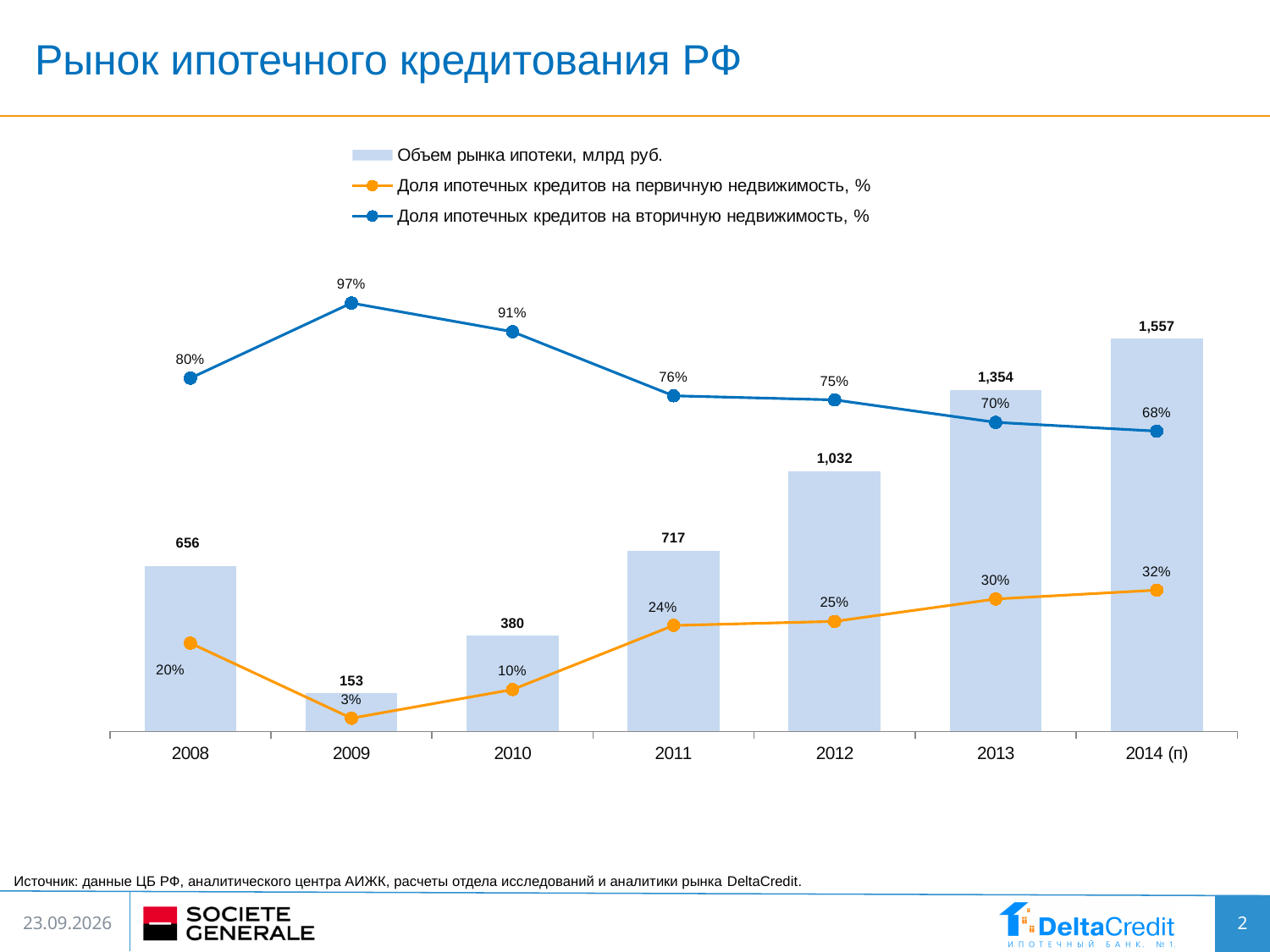
In which year is "Объем рынка ипотеки, млрд руб." the lowest? 2009 What is the value of "Доля ипотечных кредитов на вторичную недвижимость, %" for 2009? 97% Does "Доля ипотечных кредитов на вторичную недвижимость, %" rise or fall from 2009 to 2014 (п)? Fall What kind of chart is shown on the slide? Combined bar and line chart What is the value of "Доля ипотечных кредитов на первичную недвижимость, %" for 2010? 10% What colour is the line for "Доля ипотечных кредитов на первичную недвижимость, %"? Orange Which is larger: "Объем рынка ипотеки, млрд руб." in 2008 or in 2010? 2008 What is the value of "Объем рынка ипотеки, млрд руб." for 2012? 1,032 How many series does the legend list? 3 How many years are shown on the x axis? 7 What is the difference in "Объем рынка ипотеки, млрд руб." between 2014 (п) and 2013? 203 In which year is "Доля ипотечных кредитов на вторичную недвижимость, %" the highest? 2009